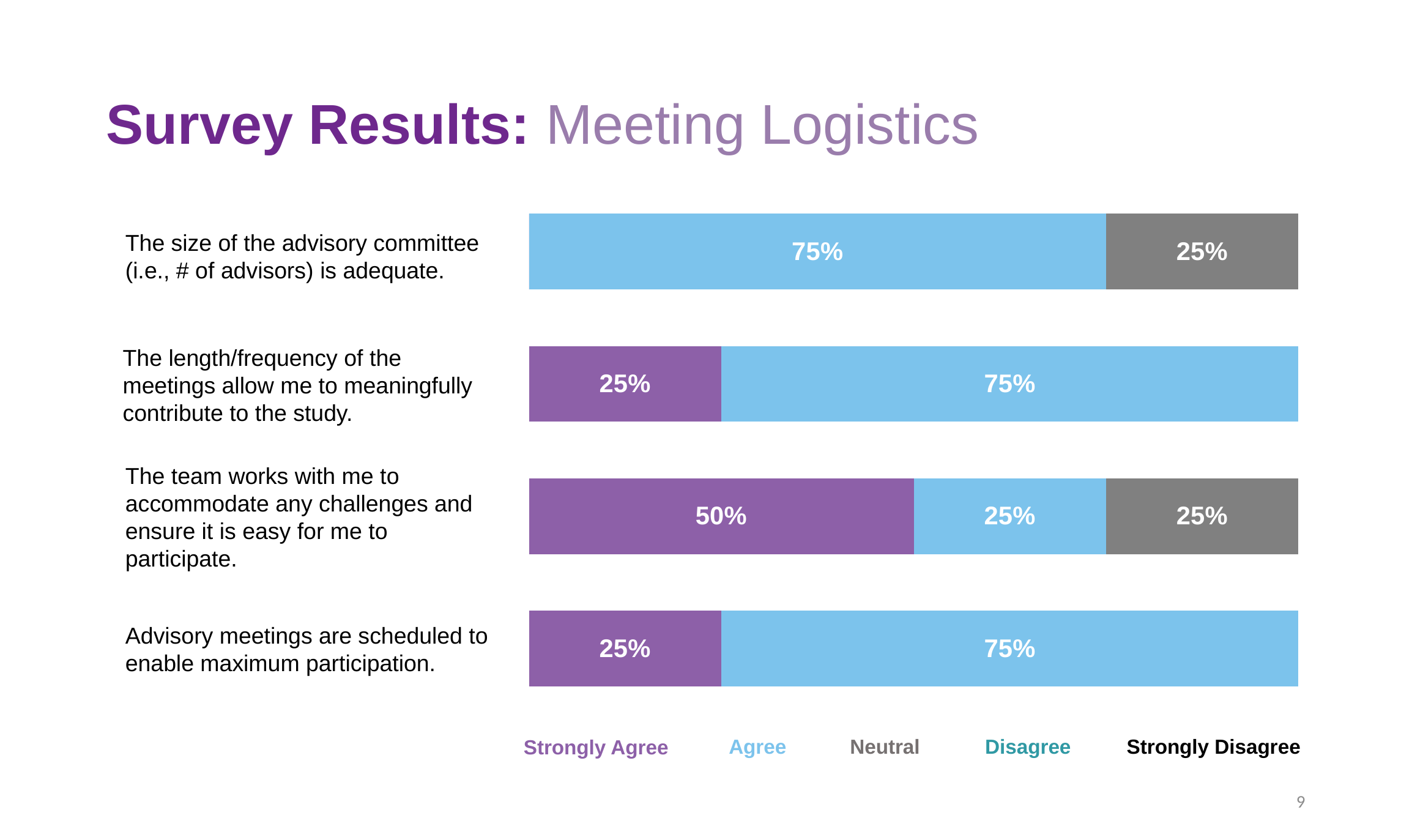
How many response categories does the legend list? 5 Which colour represents the Strongly Agree responses in the chart? Purple For the statement about the size of the advisory committee, which is larger: the Agree share or the Neutral share? Agree What percentage of respondents agreed that the length/frequency of the meetings allow them to meaningfully contribute to the study? 75% What percentage of respondents strongly agreed that advisory meetings are scheduled to enable maximum participation? 25% How many statements are shown in the chart? 4 What is the difference between the Strongly Agree and Agree percentages for the statement about the team accommodating challenges? 25% What type of chart is shown on the slide? Stacked bar chart What percentage of respondents were neutral on whether the size of the advisory committee is adequate? 25% What percentage of respondents agreed that the size of the advisory committee is adequate? 75% Which statement has the highest Strongly Agree percentage? The team works with me to accommodate any challenges and ensure it is easy for me to participate. What percentage of respondents strongly agreed that the team works with them to accommodate any challenges and ensure it is easy to participate? 50%